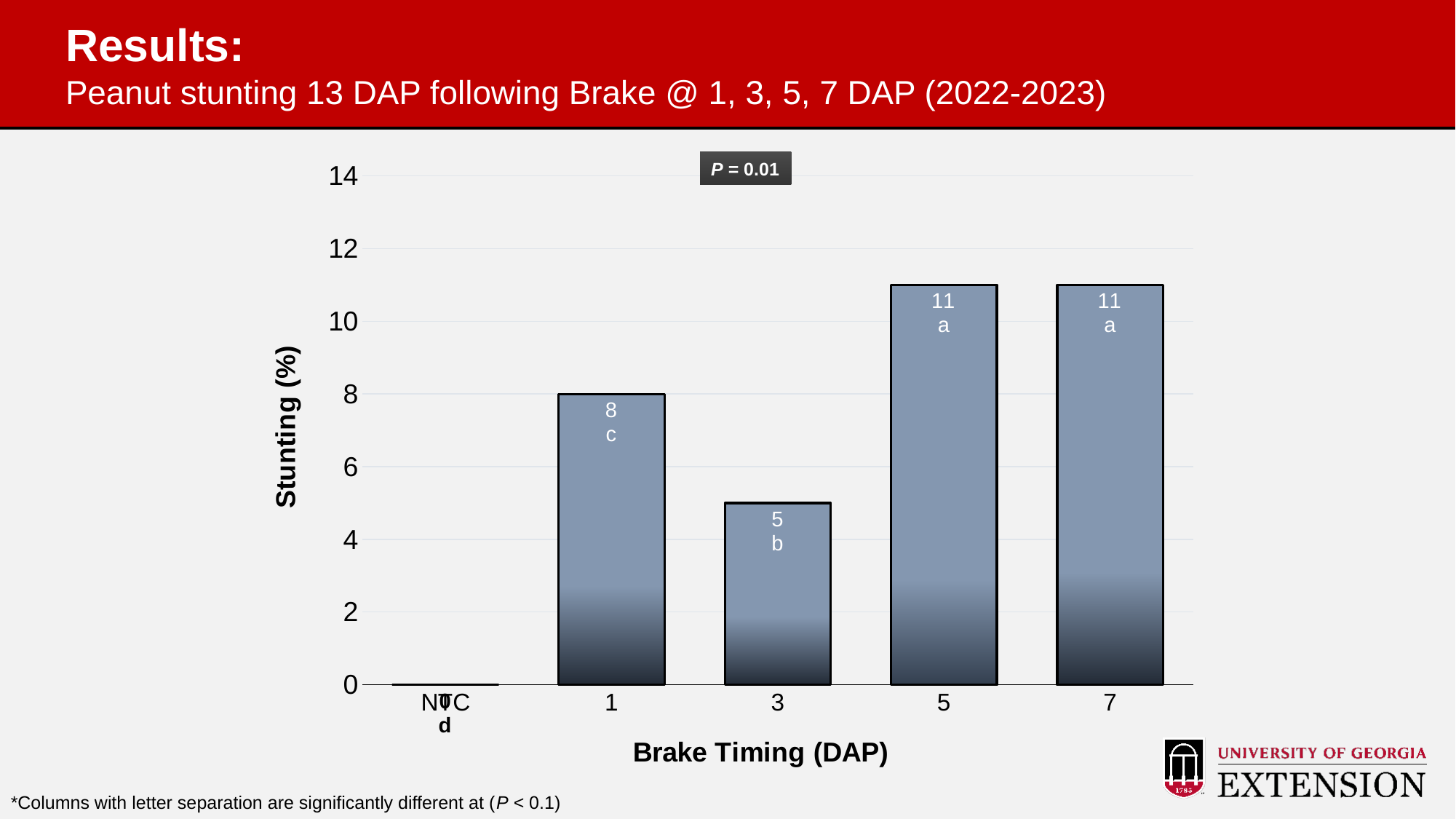
What is the stunting value for Brake timing 5 DAP? 11 What is the stunting value for Brake timing 3 DAP? 5 What is the difference in stunting between Brake timing 5 DAP and 1 DAP? 3 How many categories are shown on the x axis of the chart? 5 What is the label of the y axis of the chart? Stunting (%) What is the stunting value for Brake timing 1 DAP? 8 Which Brake timing category has the lowest stunting value? NTC What kind of chart is shown on the slide? bar chart Is the stunting value for Brake timing 5 DAP greater or less than 10? greater What is the stunting value for Brake timing 7 DAP? 11 What is the difference in stunting between Brake timing 1 DAP and 3 DAP? 3 Which has a higher stunting value, Brake timing 1 DAP or 3 DAP? 1 DAP